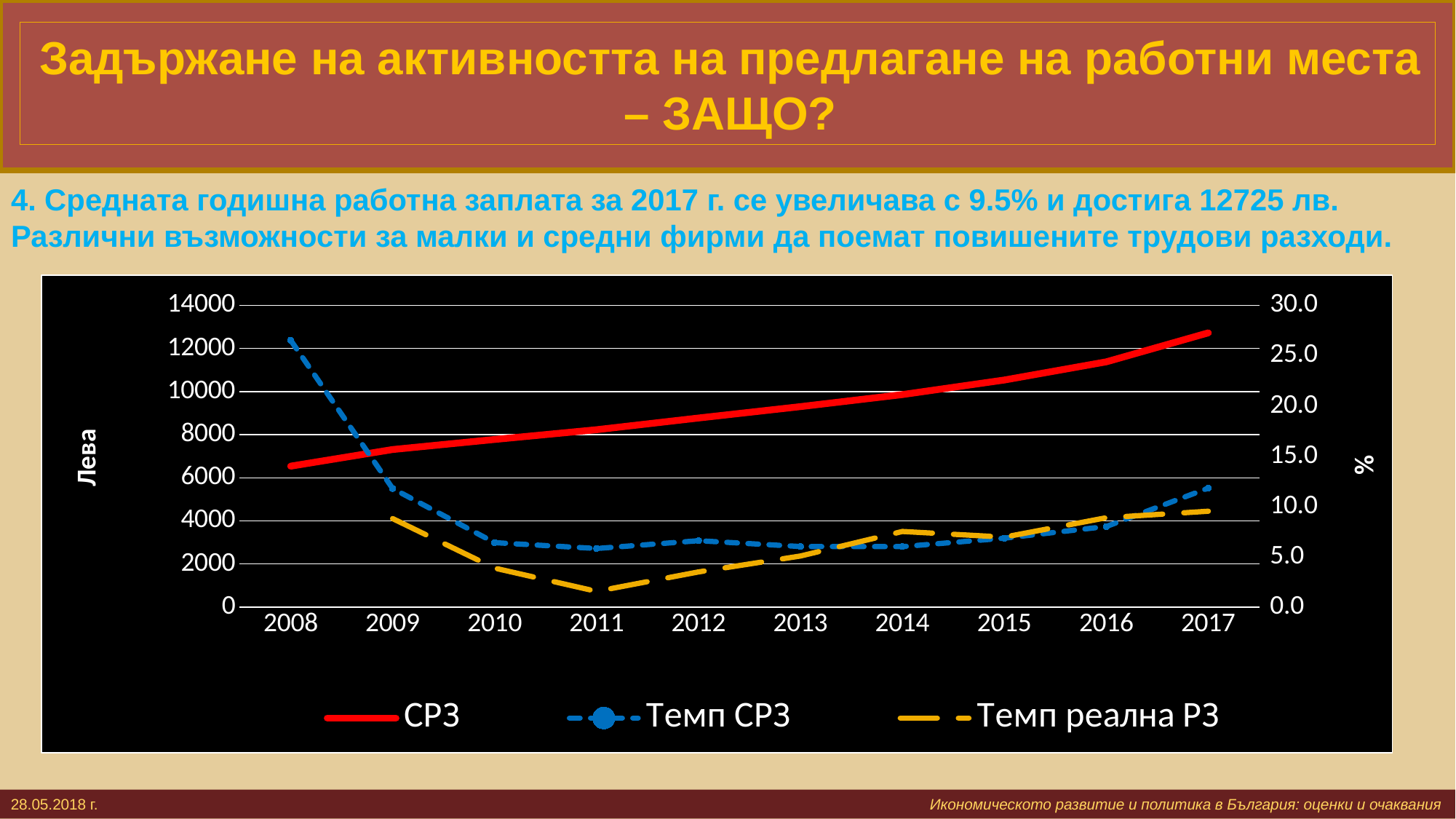
Is the value for СРЗ in 2017 greater or less than 12000? greater Is the value for Темп реална РЗ in 2011 greater or less than 5.0? less What kind of chart is shown on the slide? line chart In which year is the СРЗ series lowest? 2008 Is the value for Темп СРЗ in 2008 greater or less than 25.0? greater How many years are shown on the x axis of the chart? 10 Does the СРЗ series rise or fall from 2008 to 2017? rise In which year is the СРЗ series highest? 2017 In which year is the Темп СРЗ series highest? 2008 How many series does the chart legend list? 3 In which year is the Темп реална РЗ series lowest? 2011 What is the label of the left vertical axis of the chart? Лева